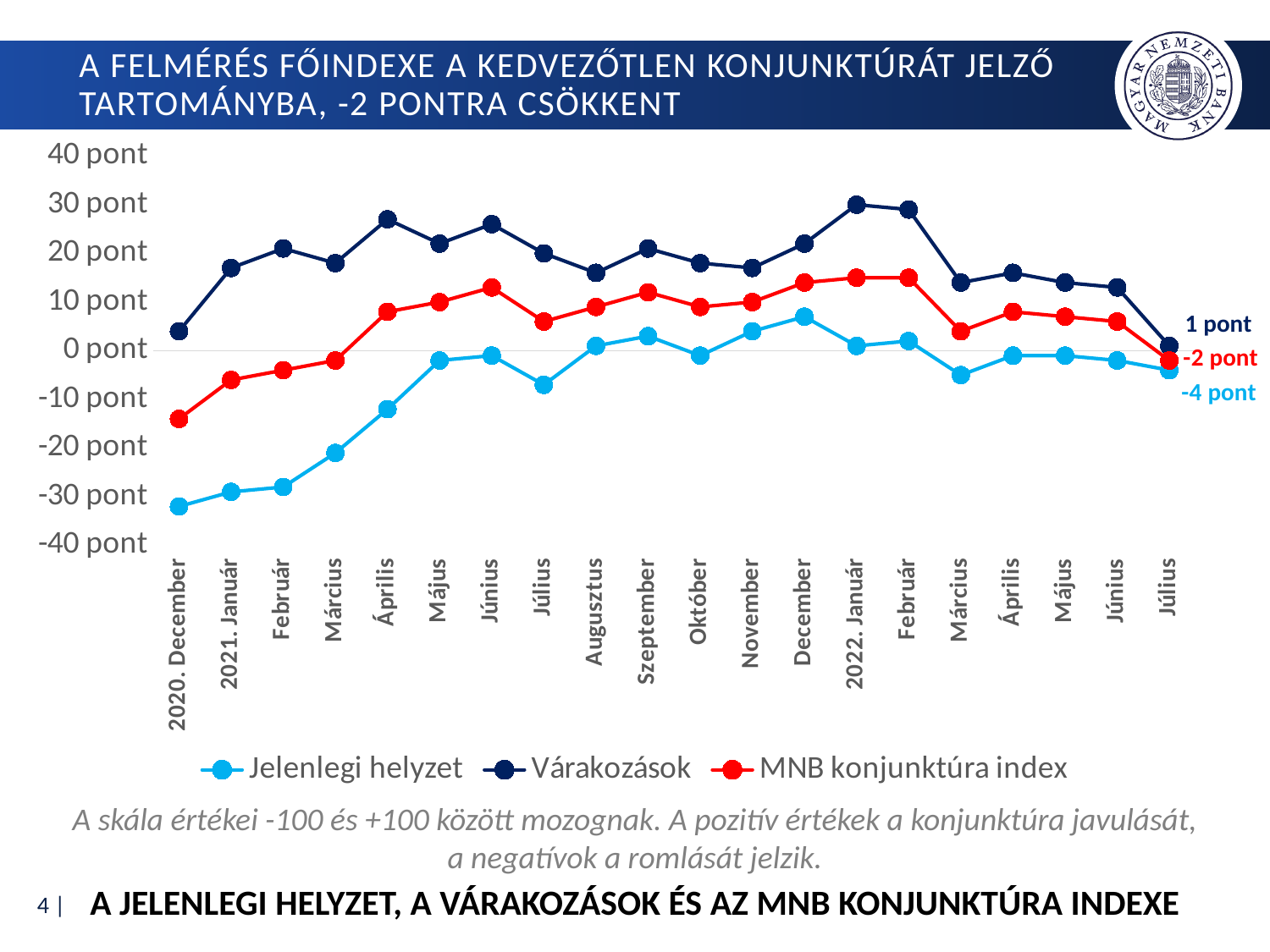
In which month is the MNB konjunktúra index at its lowest? 2020. December What kind of chart is shown on the slide? line chart Does the Jelenlegi helyzet series rise or fall from 2020 December to 2021 Május? rise What is the value of the MNB konjunktúra index in 2022 Július? -2 pont What is the value of the Várakozások series in 2022 Július? 1 pont In 2022 Július, what is the difference between the Várakozások value and the Jelenlegi helyzet value? 5 pont In 2022 Július, which is larger: the Várakozások value or the MNB konjunktúra index value? Várakozások How many months are plotted along the x axis? 20 Is the Jelenlegi helyzet value in 2020 December greater or less than -30 pont? less How many series does the legend list? 3 Is the Várakozások value in 2021 Április greater or less than 20 pont? greater What is the value of the Jelenlegi helyzet series in 2022 Július? -4 pont